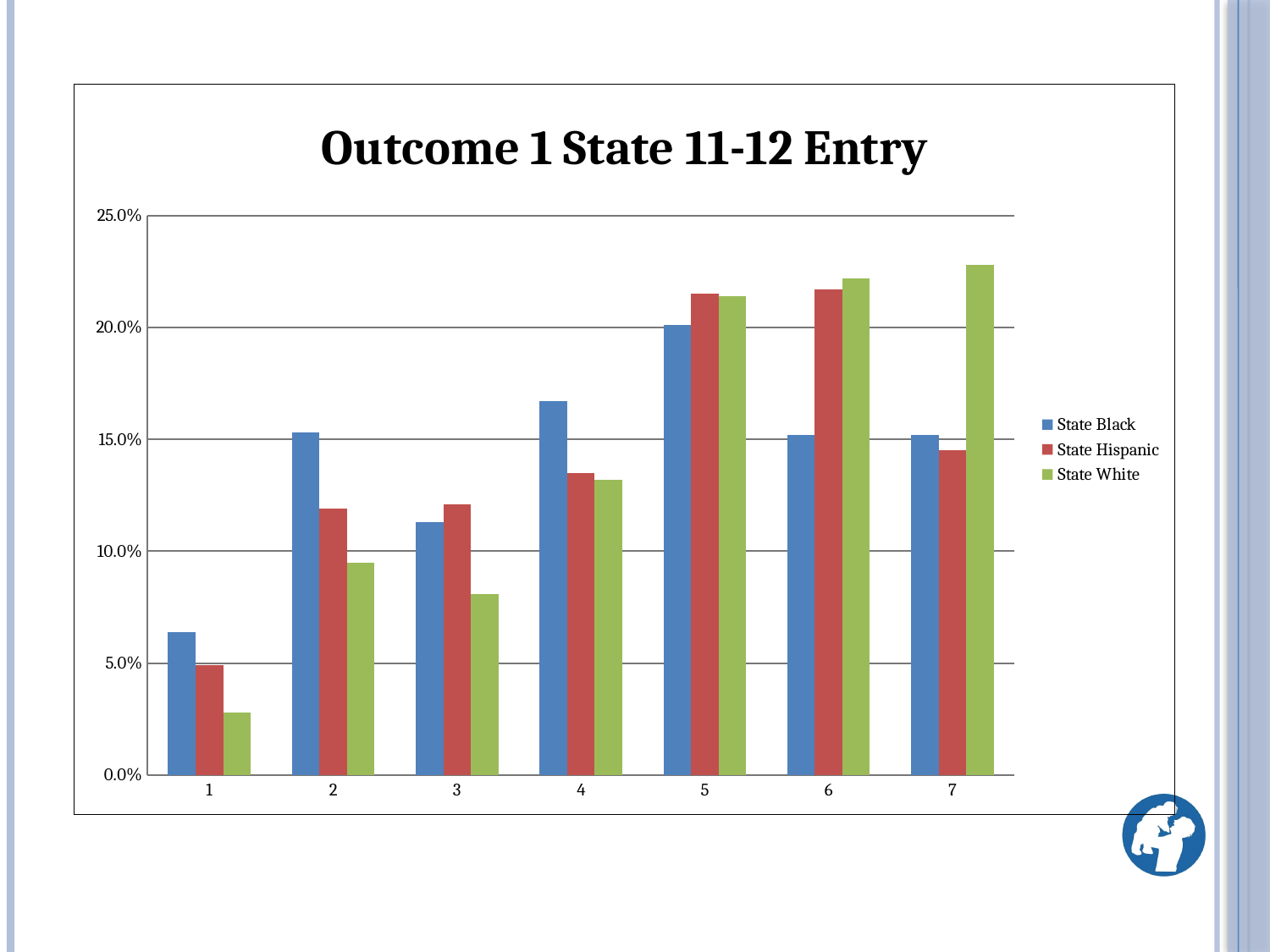
For which category is the State White value lowest? 1 In category 7, which is larger: State White or State Hispanic? State White Is the State White value for category 2 greater or less than 10.0%? less Is the State Hispanic value for category 5 greater or less than 20.0%? greater What is the title of the chart? Outcome 1 State 11-12 Entry How many series does the legend list? 3 What kind of chart is shown on the slide? bar chart Is the State Black value for category 1 greater or less than 5.0%? greater In category 1, which is larger: State Black or State White? State Black For which category is the State Black value highest? 5 For which category is the State White value highest? 7 How many categories are shown on the x axis? 7